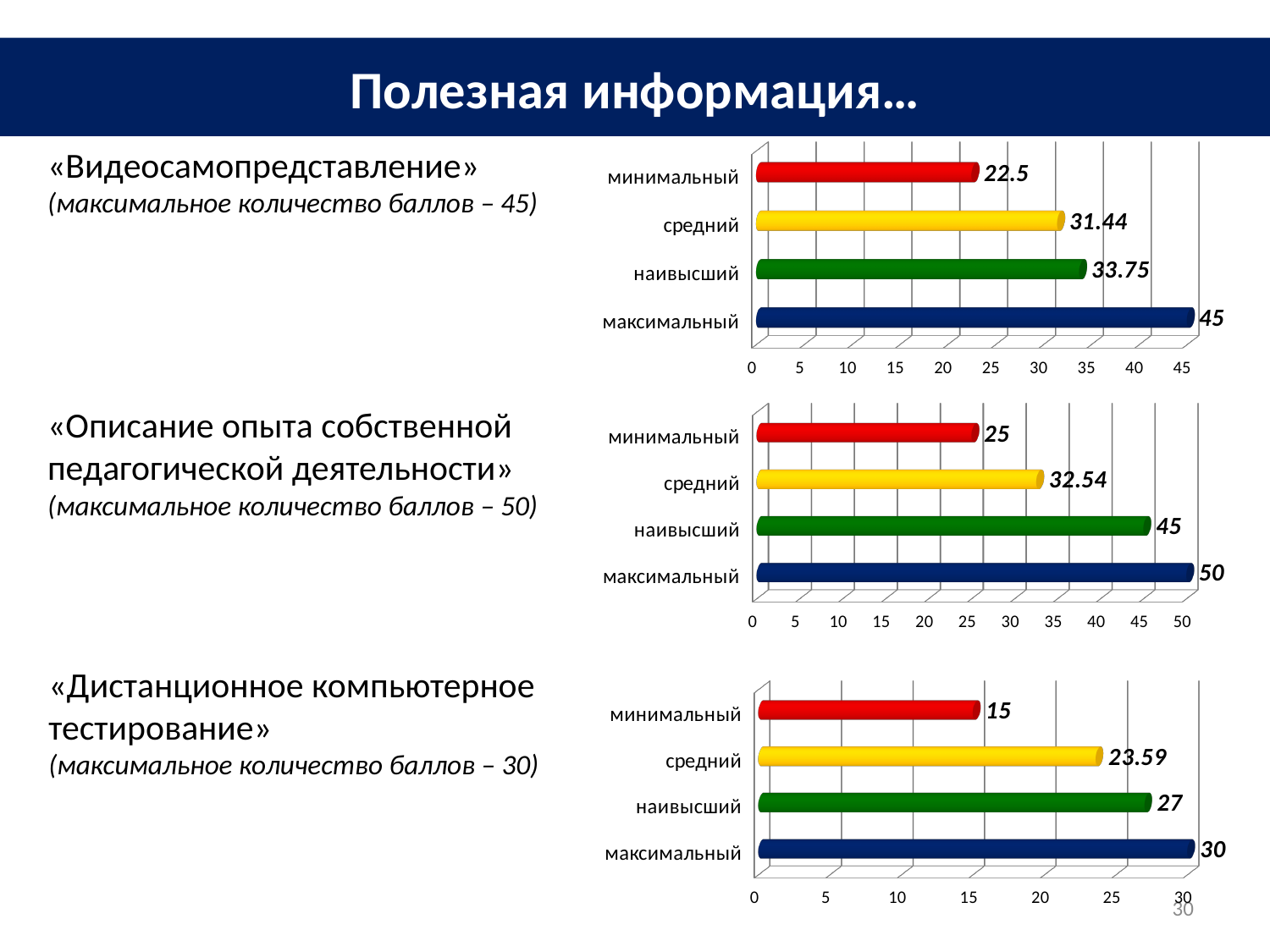
In the middle chart («Описание опыта собственной педагогической деятельности»), which is larger, средний or минимальный? средний In the middle chart («Описание опыта собственной педагогической деятельности»), which category has the highest value? максимальный In the top chart («Видеосамопредставление»), what is the value for средний? 31.44 In the top chart («Видеосамопредставление»), what is the difference between максимальный and наивысший? 11.25 How many categories does the top chart («Видеосамопредставление») show? 4 In the middle chart («Описание опыта собственной педагогической деятельности»), what colour is the bar for наивысший? green In the middle chart («Описание опыта собственной педагогической деятельности»), what is the value for наивысший? 45 In the bottom chart («Дистанционное компьютерное тестирование»), what is the value for средний? 23.59 In the bottom chart («Дистанционное компьютерное тестирование»), which category has the lowest value? минимальный In the top chart («Видеосамопредставление»), what is the value for минимальный? 22.5 What type of chart is the bottom chart («Дистанционное компьютерное тестирование»)? bar chart In the bottom chart («Дистанционное компьютерное тестирование»), what is the difference between наивысший and минимальный? 12